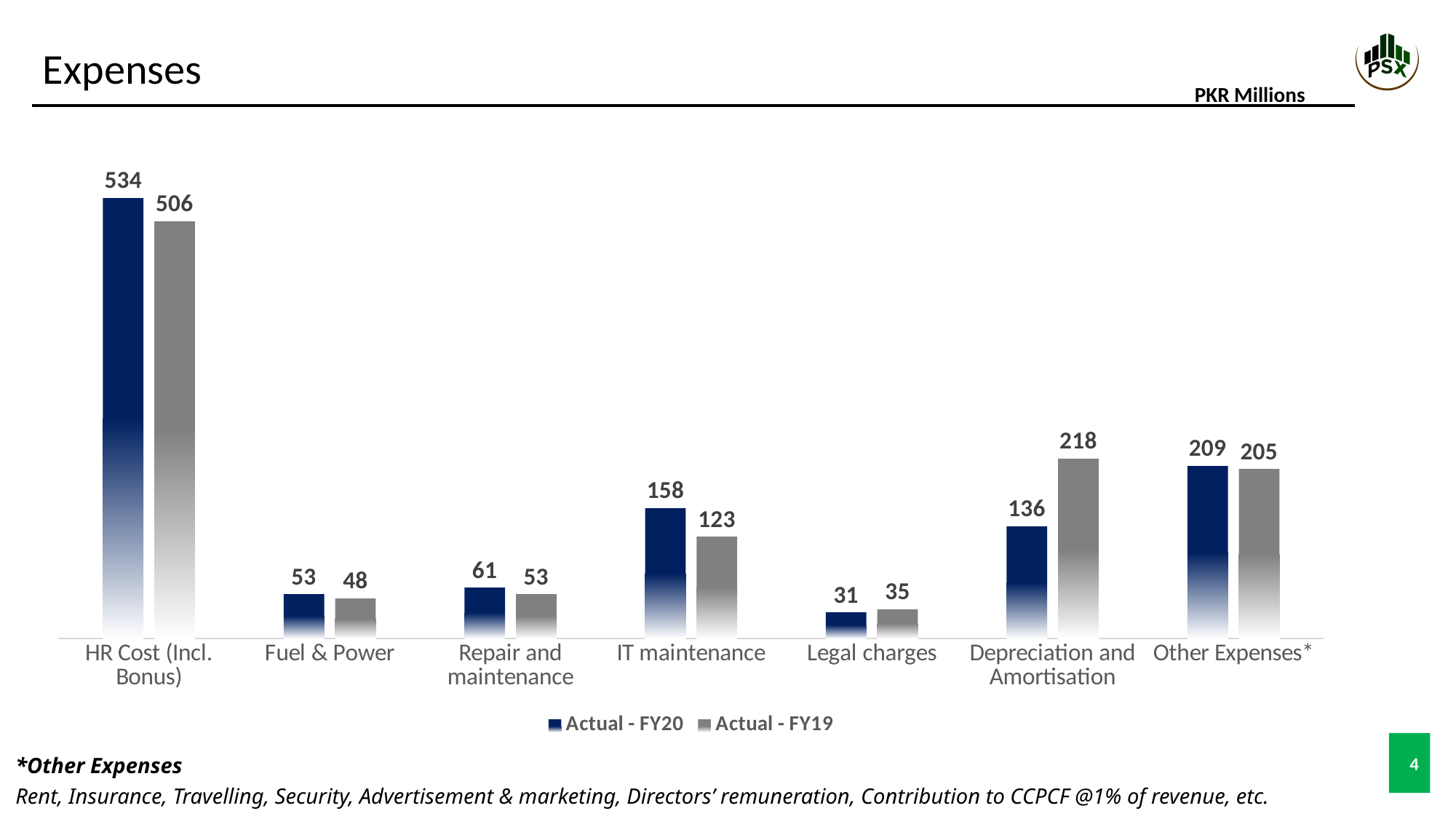
What is the difference between the Actual - FY20 and Actual - FY19 values for IT maintenance? 35 What is the Actual - FY20 value for IT maintenance? 158 Which category has the highest Actual - FY20 value? HR Cost (Incl. Bonus) What is the Actual - FY19 value for Depreciation and Amortisation? 218 How many series does the legend list? 2 Which is larger for Legal charges, Actual - FY20 or Actual - FY19? Actual - FY19 Which category has the lowest Actual - FY19 value? Legal charges What unit is stated for the values on the chart? PKR Millions What is the Actual - FY20 value for HR Cost (Incl. Bonus)? 534 What kind of chart is shown on the slide? Bar chart How many expense categories are shown on the chart? 7 What is the difference between the Actual - FY19 and Actual - FY20 values for Depreciation and Amortisation? 82